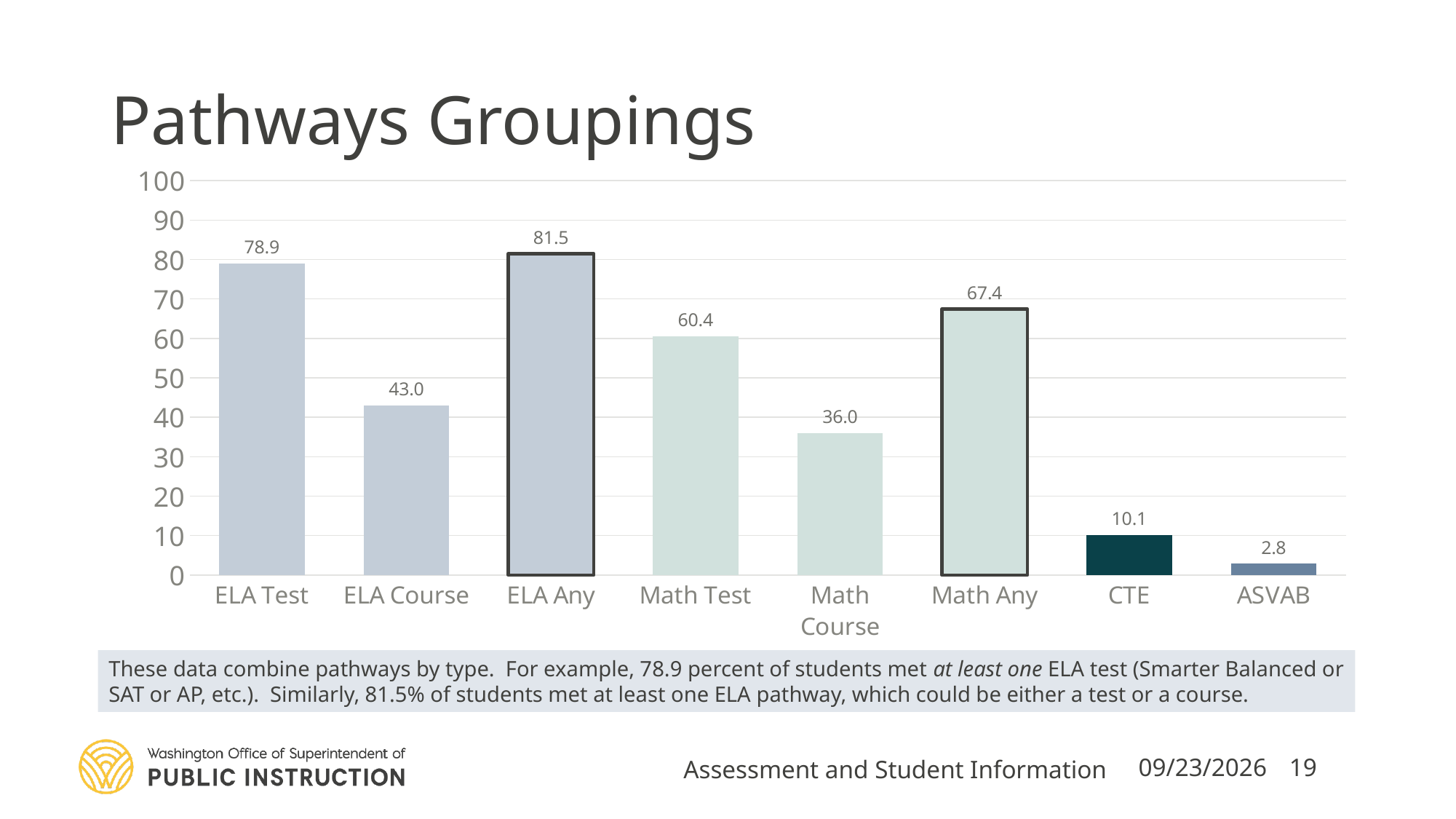
What kind of chart is shown on the slide? bar chart Which category has the lowest value? ASVAB What is the value for ASVAB? 2.8 What is the value for ELA Test? 78.9 Is the value for CTE greater or less than 20? less Which is larger, the value for ELA Course or the value for Math Test? Math Test How many categories are shown on the x axis? 8 What is the difference between the values for Math Any and Math Test? 7.0 Which two bars are drawn with a dark outline? ELA Any and Math Any Which category has the highest value? ELA Any What is the difference between the values for ELA Any and ELA Test? 2.6 What is the value for Math Course? 36.0